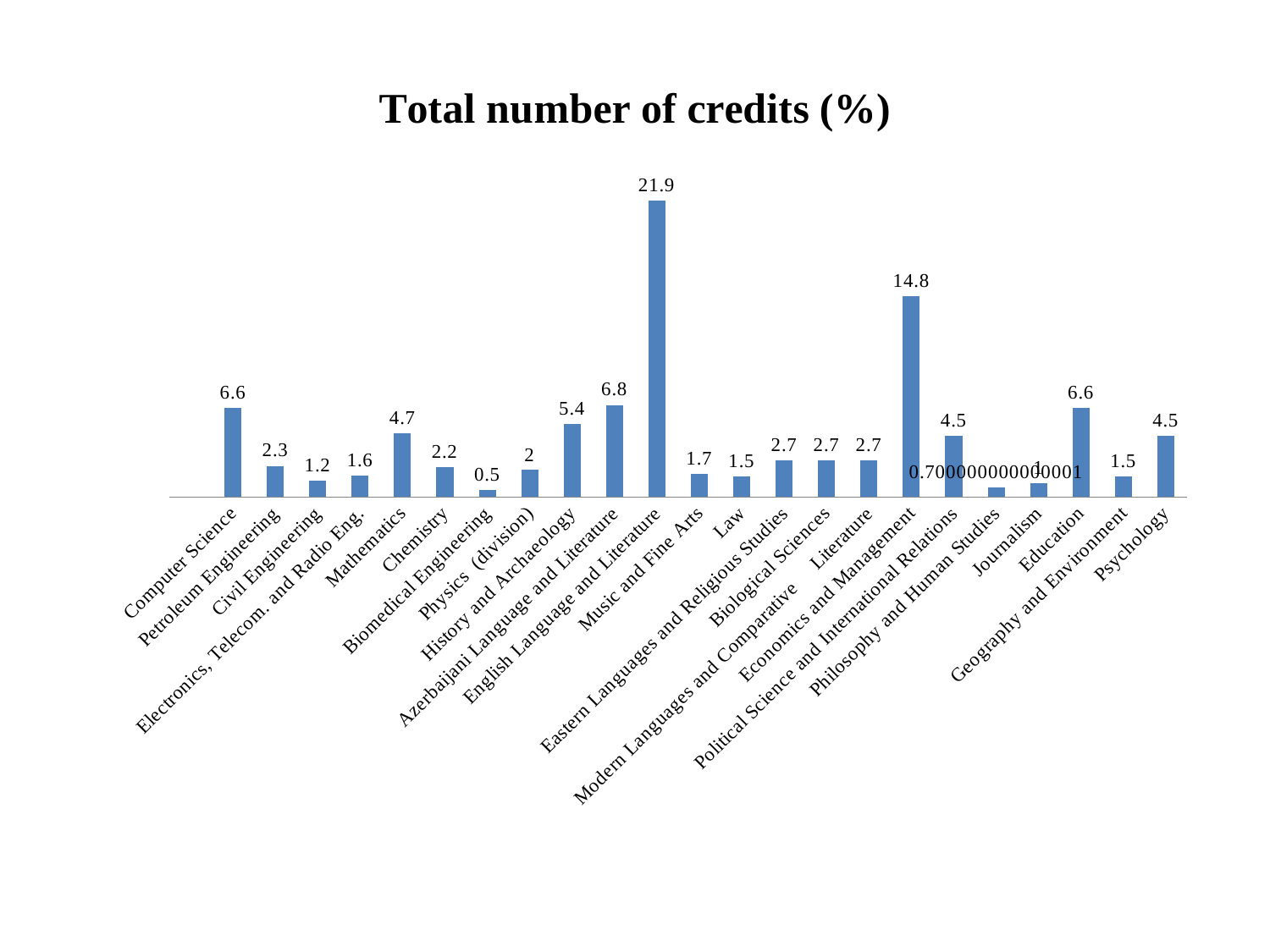
How many categories are shown in the chart? 23 What is the value for History and Archaeology? 5.4 What is the value for English Language and Literature? 21.9 What is the value for Biomedical Engineering? 0.5 What kind of chart is shown on the slide? bar chart What is the value for Computer Science? 6.6 What is the difference between the values for Azerbaijani Language and Literature and Petroleum Engineering? 4.5 What is the value for Economics and Management? 14.8 What is the difference between the values for English Language and Literature and Economics and Management? 7.1 Which is larger, the value for Mathematics or the value for Chemistry? Mathematics What is the title of the chart? Total number of credits (%) Which category has the highest value? English Language and Literature